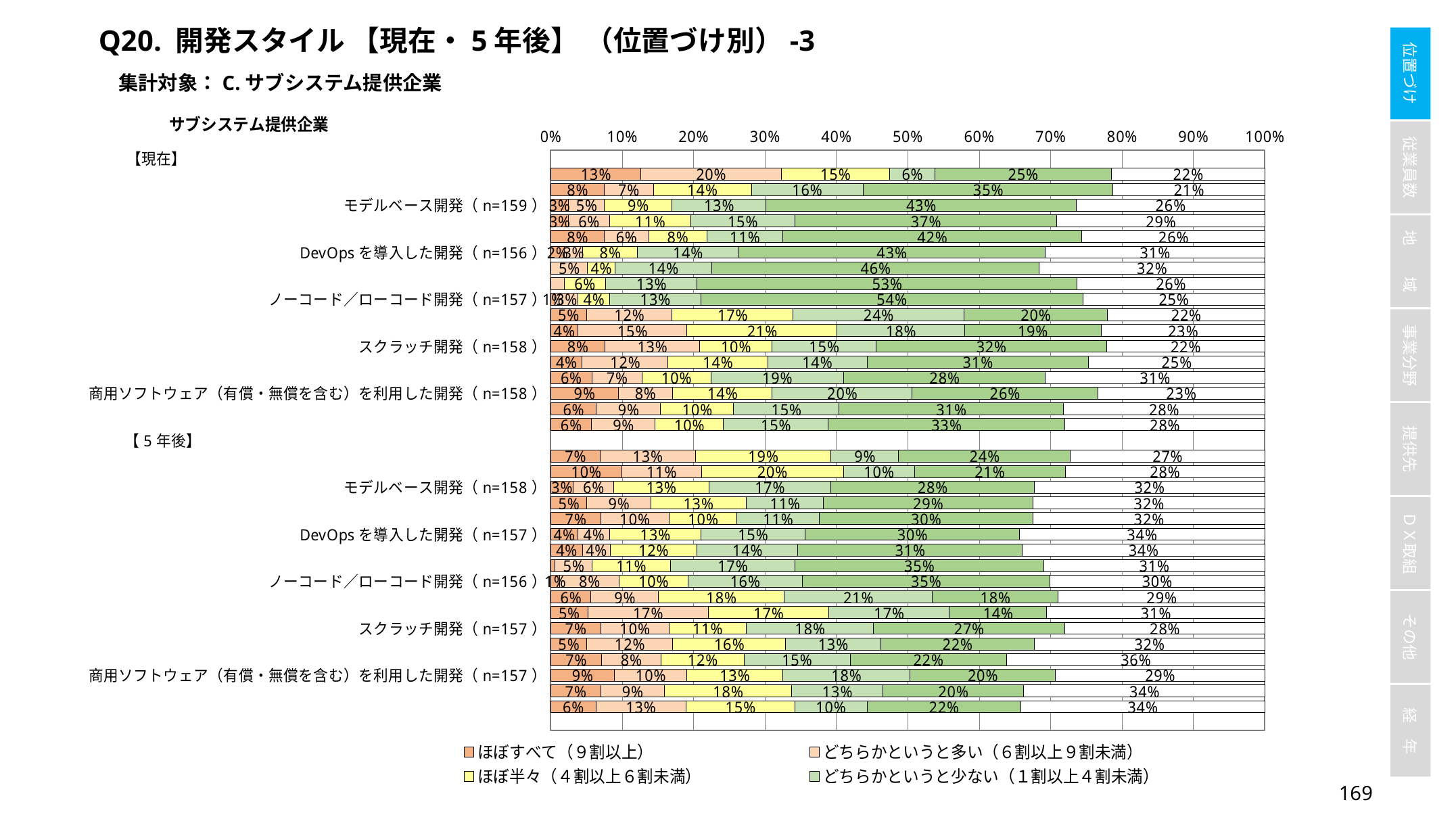
What kind of chart is shown on the slide? stacked bar chart In the bottom bar of the 【5年後】 section, what is the value of the rightmost (white) segment? 34% What is the maximum value shown on the horizontal axis? 100% How many entries does the chart legend list? 4 In the topmost bar of the 【現在】 section, what is the value of the rightmost (white) segment? 22% In the topmost bar of the 【現在】 section, what is the value of the ほぼすべて（9割以上） segment? 13% In the topmost bar of the 【現在】 section, what is the difference between the どちらかというと多い segment and the ほぼすべて segment? 7 percentage points What is the title of the slide? Q20. 開発スタイル【現在・5年後】（位置づけ別）-3 In the topmost bar of the 【5年後】 section, what is the value of the ほぼ半々（4割以上6割未満） segment? 19% In the topmost bar of the 【現在】 section, which is larger: the ほぼすべて segment or the ほぼ半々 segment? ほぼ半々（4割以上6割未満） How many development-style categories are labeled in the 【現在】 section? 5